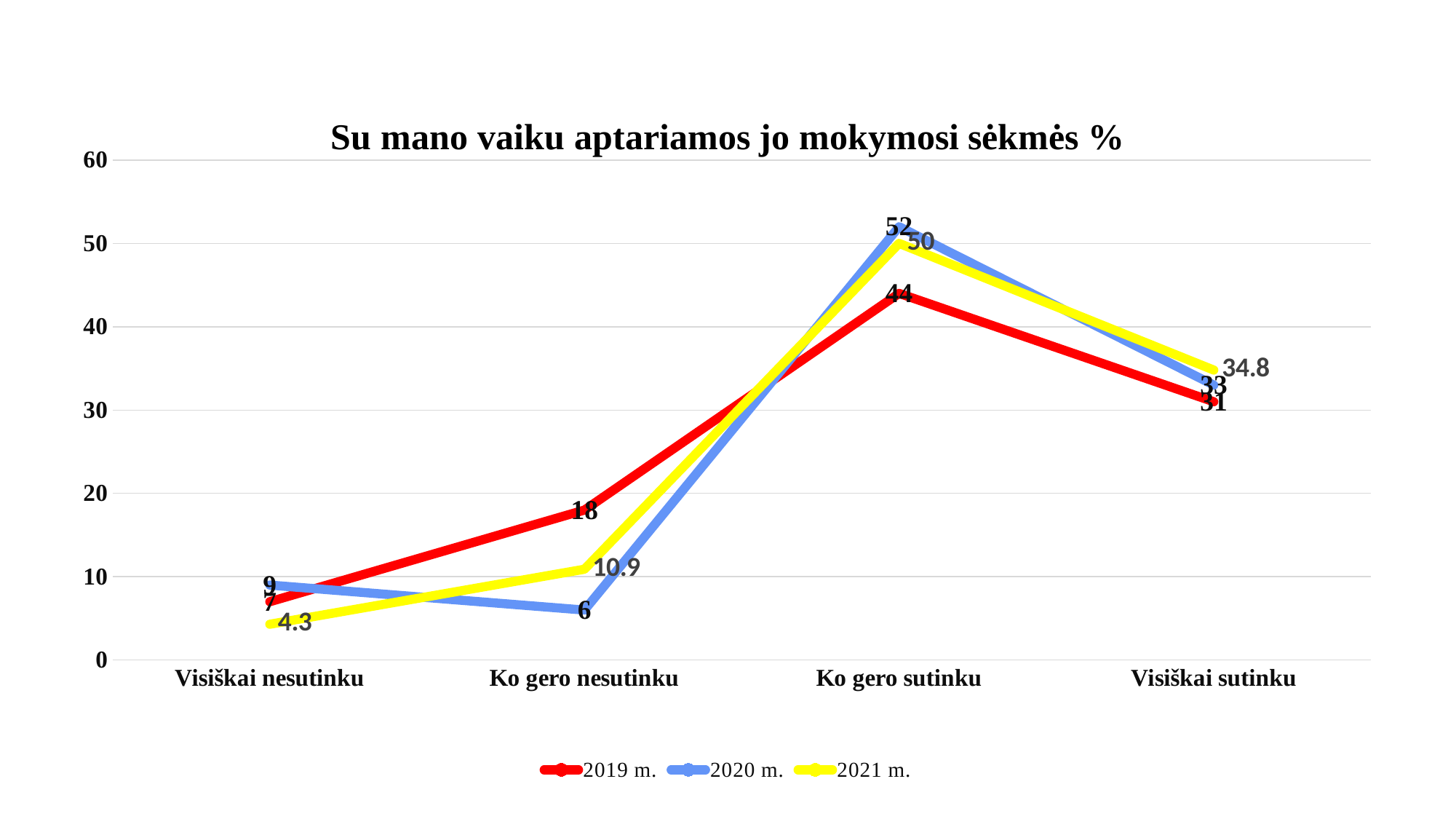
What is the value for 2020 m. at Ko gero sutinku? 52 Which category has the lowest value for the 2021 m. series? Visiškai nesutinku What is the title of the chart? Su mano vaiku aptariamos jo mokymosi sėkmės % What is the difference between the 2020 m. and 2019 m. values at Ko gero sutinku? 8 How many series does the legend list? 3 Which category has the highest value for the 2019 m. series? Ko gero sutinku What is the value for 2021 m. at Visiškai sutinku? 34.8 How many categories are shown on the x axis? 4 What type of chart is shown on the slide? line chart What is the value for 2019 m. at Ko gero nesutinku? 18 What is the value for 2021 m. at Visiškai nesutinku? 4.3 At Ko gero nesutinku, which series has the larger value, 2019 m. or 2020 m.? 2019 m.